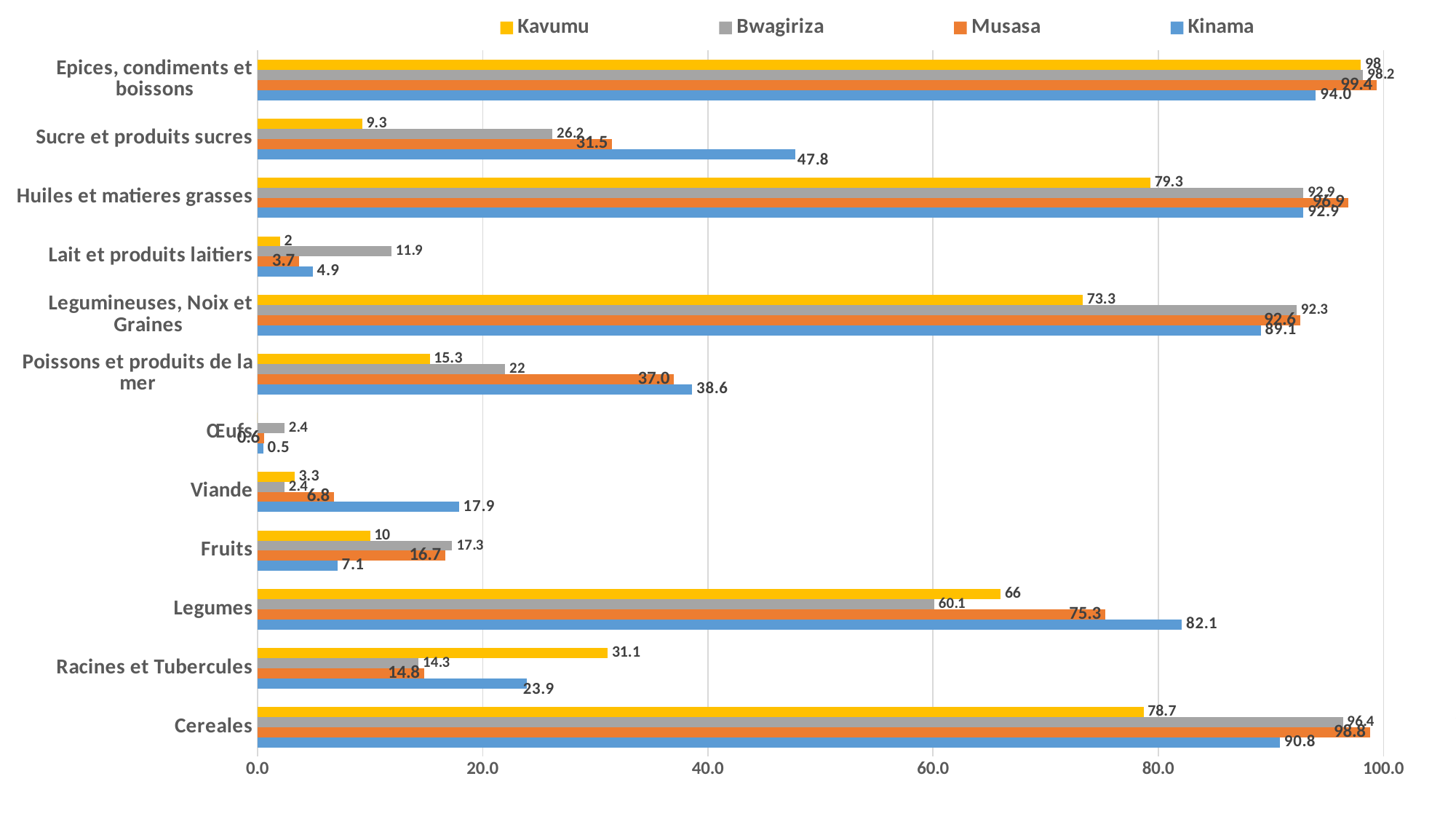
What is the value for Kinama in the Sucre et produits sucres category? 47.8 How many food categories are shown on the chart? 12 How many series does the legend list? 4 What kind of chart is shown on the slide? Bar chart Which is larger in the Fruits category, the Bwagiriza value or the Musasa value? Bwagiriza Which series has the highest value in the Racines et Tubercules category? Kavumu What is the difference between the Kinama and Kavumu values for Legumes? 16.1 Which colour represents the Kinama series? Blue What is the value for Bwagiriza in the Lait et produits laitiers category? 11.9 What is the value for Musasa in the Cereales category? 98.8 Which series has the lowest value in the Viande category? Bwagiriza What is the value for Kavumu in the Legumes category? 66